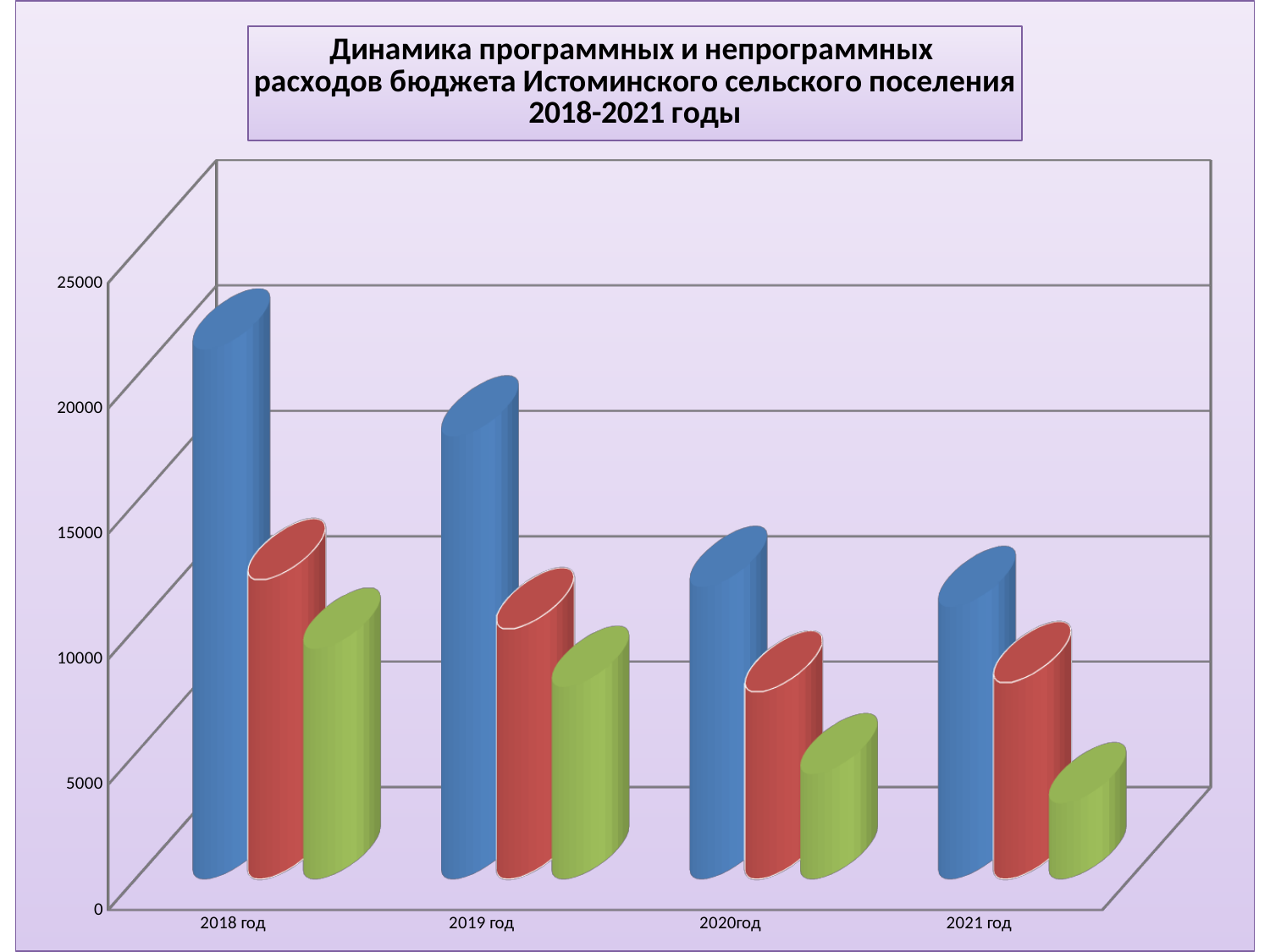
Which of the three bars for 2018 год is the shortest? the green bar Which year has the highest blue bar? 2018 год Which is larger: the blue bar for 2018 год or the blue bar for 2021 год? the blue bar for 2018 год Is the value of the red bar for 2018 год greater or less than 10000? greater Do the blue bars rise or fall from 2018 год to 2021 год? fall Is the value of the red bar for 2019 год greater or less than 15000? less What kind of chart is shown on the slide? bar chart Is the value of the blue bar for 2019 год greater or less than 15000? greater How many year categories are shown on the x axis? 4 How many bars are plotted for each year category? 3